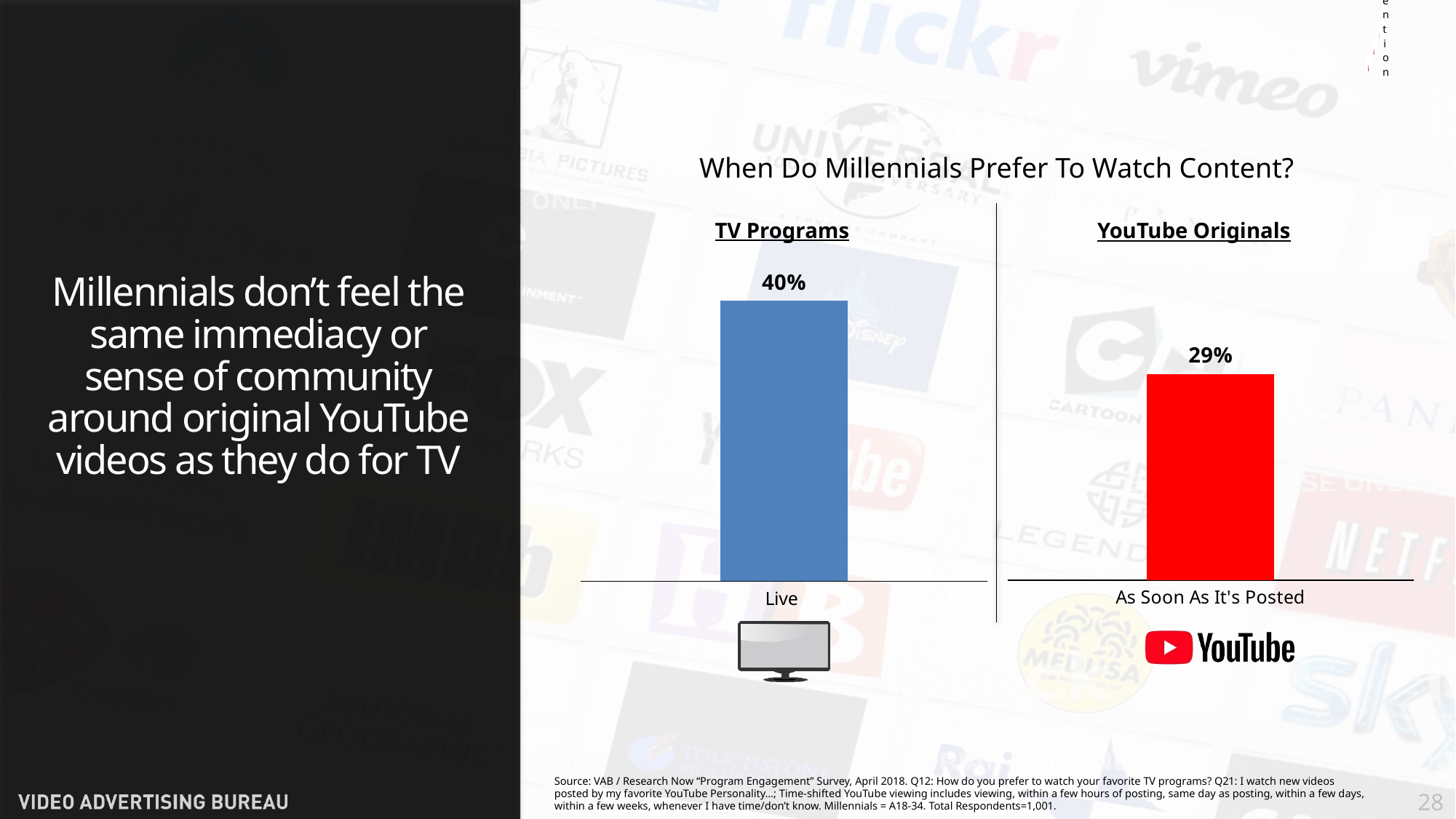
What is the category label of the bar in the YouTube Originals chart? As Soon As It's Posted In the TV Programs chart, what percentage of millennials prefer to watch live? 40% How many bars are plotted in the YouTube Originals chart? 1 In the YouTube Originals chart, what percentage of millennials prefer to watch as soon as it's posted? 29% What type of chart is used in the TV Programs chart? Bar chart Which is larger: the Live value in the TV Programs chart or the As Soon As It's Posted value in the YouTube Originals chart? Live (TV Programs) What is the category label of the bar in the TV Programs chart? Live Is the value for Live in the TV Programs chart greater or less than 30%? greater What is the difference between the Live value in the TV Programs chart and the As Soon As It's Posted value in the YouTube Originals chart? 11% What is the overall title above the two charts? When Do Millennials Prefer To Watch Content?